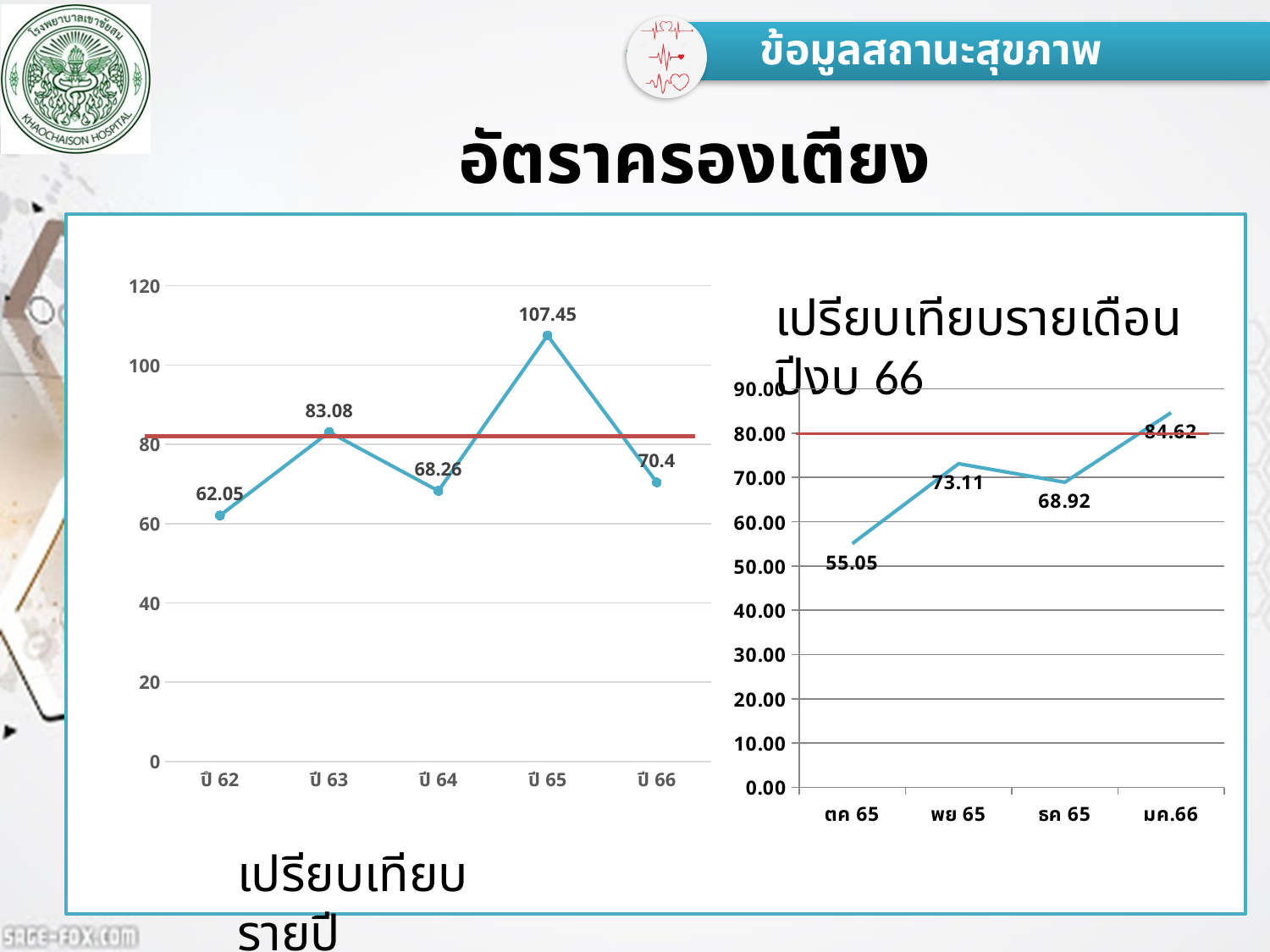
In the left chart (yearly comparison), which year has the highest value? ปี 65 In the left chart (yearly comparison), what is the value for ปี 65? 107.45 In the left chart (yearly comparison), how many years are plotted on the x axis? 5 In the right chart (monthly comparison, fiscal year 66), what is the value for มค.66? 84.62 In the right chart (monthly comparison, fiscal year 66), what is the value for ตค 65? 55.05 In the left chart (yearly comparison), what is the value for ปี 62? 62.05 In the left chart (yearly comparison), which year has the lowest value? ปี 62 In the left chart (yearly comparison), what is the difference between the values for ปี 65 and ปี 66? 37.05 What type of chart is the left chart (yearly comparison)? Line chart In the right chart (monthly comparison, fiscal year 66), which month has the lowest value? ตค 65 In the right chart (monthly comparison, fiscal year 66), which is larger, the value for พย 65 or ธค 65? พย 65 In the right chart (monthly comparison, fiscal year 66), what is the difference between the values for มค.66 and ตค 65? 29.57